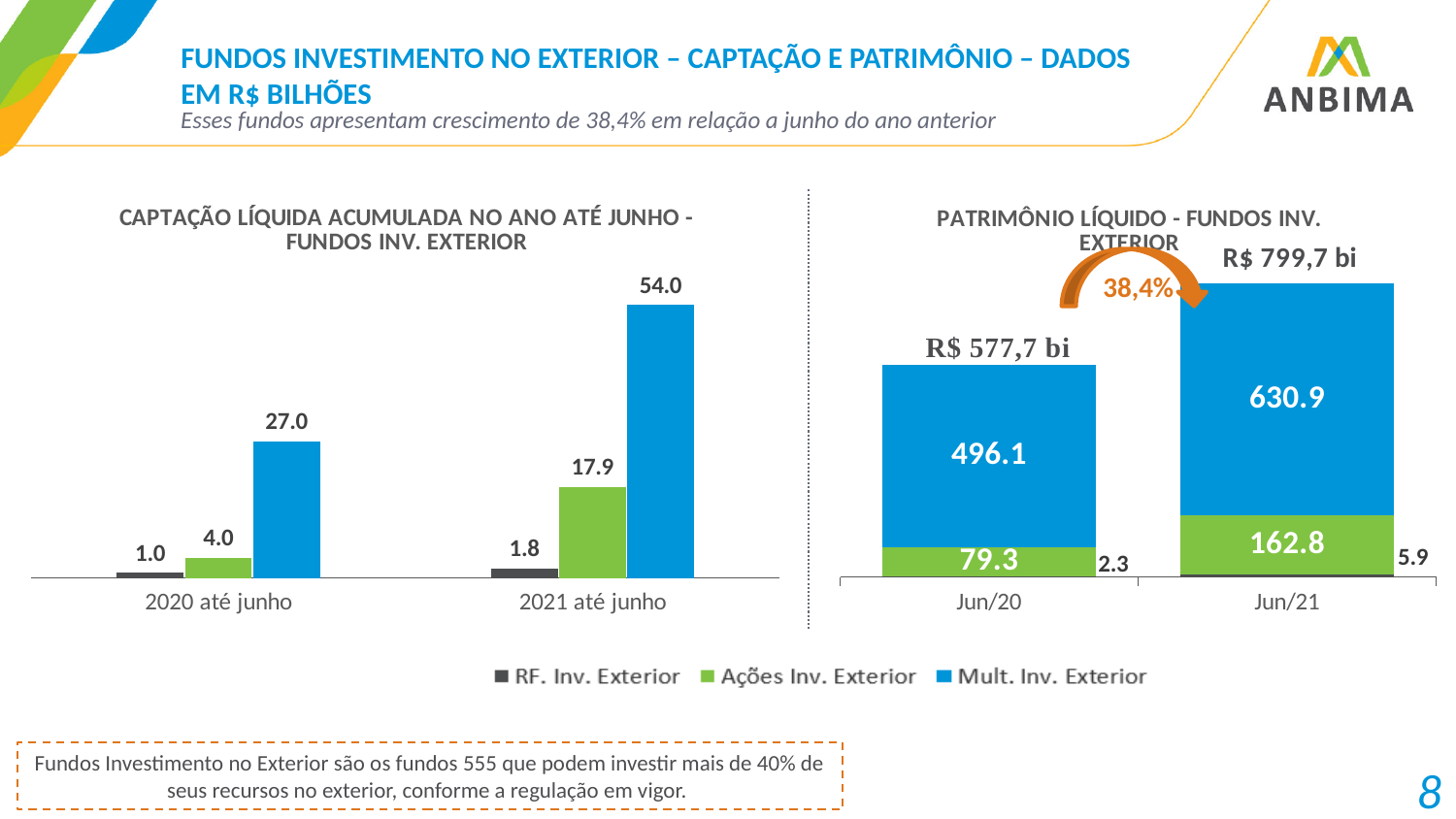
In the 'CAPTAÇÃO LÍQUIDA ACUMULADA NO ANO ATÉ JUNHO' chart, which series has the highest value in 2021 até junho? Mult. Inv. Exterior In the 'CAPTAÇÃO LÍQUIDA ACUMULADA NO ANO ATÉ JUNHO' chart, what is the value for Ações Inv. Exterior in 2020 até junho? 4.0 What kind of chart is the 'PATRIMÔNIO LÍQUIDO - FUNDOS INV. EXTERIOR' chart? Stacked bar chart In the 'PATRIMÔNIO LÍQUIDO - FUNDOS INV. EXTERIOR' chart, what is the value for Mult. Inv. Exterior in Jun/21? 630.9 In the 'CAPTAÇÃO LÍQUIDA ACUMULADA NO ANO ATÉ JUNHO' chart, what is the value for Mult. Inv. Exterior in 2021 até junho? 54.0 In the 'PATRIMÔNIO LÍQUIDO - FUNDOS INV. EXTERIOR' chart, what is the total of the Jun/21 stacked bar as labelled on the slide? R$ 799,7 bi In the 'CAPTAÇÃO LÍQUIDA ACUMULADA NO ANO ATÉ JUNHO' chart, which series has the lowest value in 2020 até junho? RF. Inv. Exterior In the 'PATRIMÔNIO LÍQUIDO - FUNDOS INV. EXTERIOR' chart, what is the value for Ações Inv. Exterior in Jun/20? 79.3 In the 'PATRIMÔNIO LÍQUIDO - FUNDOS INV. EXTERIOR' chart, is the Ações Inv. Exterior value larger in Jun/20 or Jun/21? Jun/21 How many series does the legend list? 3 In the 'CAPTAÇÃO LÍQUIDA ACUMULADA NO ANO ATÉ JUNHO' chart, what is the value for RF. Inv. Exterior in 2021 até junho? 1.8 In the 'CAPTAÇÃO LÍQUIDA ACUMULADA NO ANO ATÉ JUNHO' chart, what is the difference between the Mult. Inv. Exterior values for 2021 até junho and 2020 até junho? 27.0